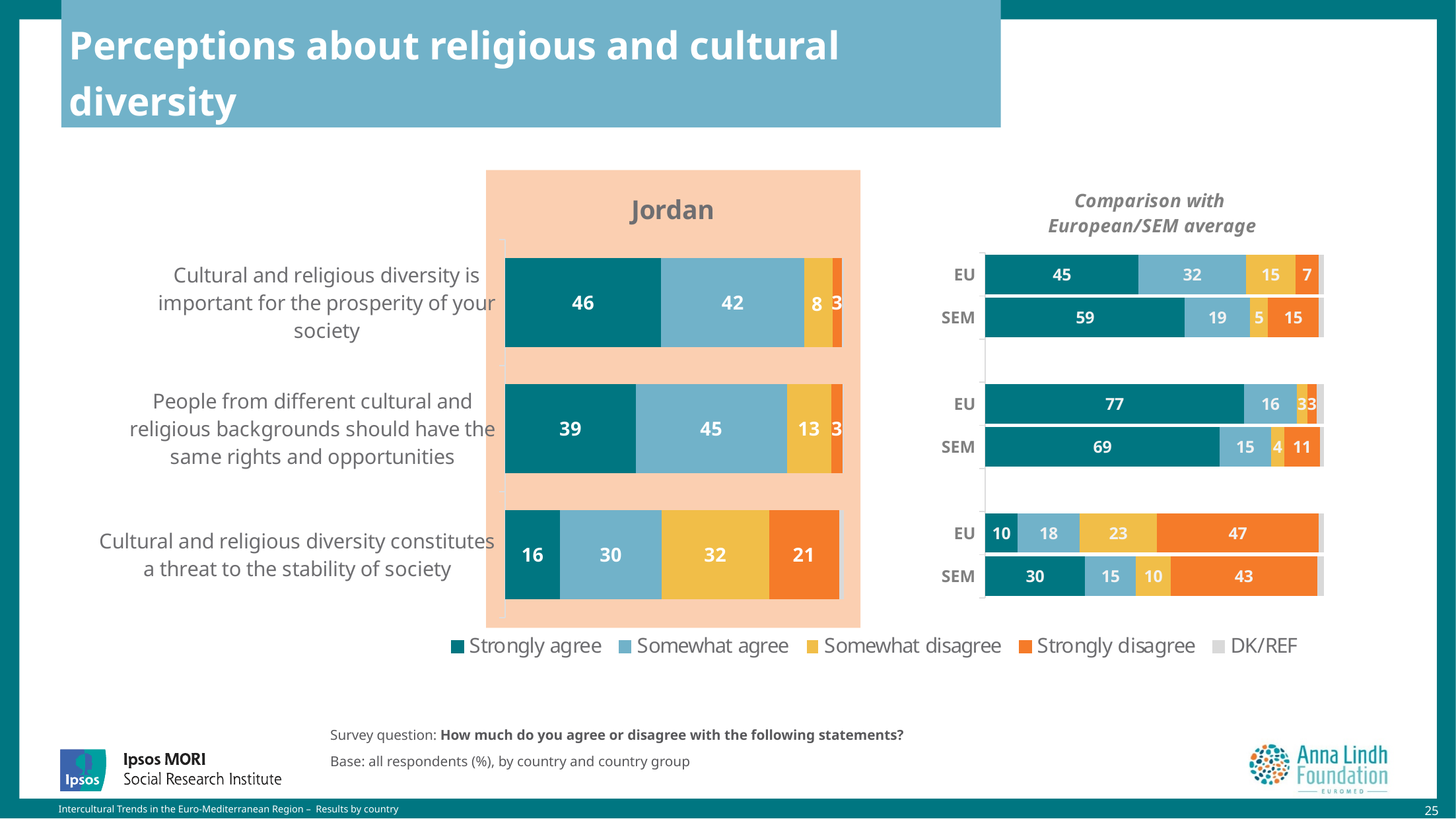
What kind of chart is the Jordan chart? Stacked bar chart In the Comparison with European/SEM average chart, what is the difference between the SEM and EU 'Strongly agree' values for the statement that diversity is important for the prosperity of your society? 14 In the Jordan chart, what percentage strongly agree that cultural and religious diversity is important for the prosperity of your society? 46 In the Comparison with European/SEM average chart, what is the EU 'Strongly agree' value for the statement that people from different backgrounds should have the same rights and opportunities? 77 In the Jordan chart, for the statement that people from different backgrounds should have the same rights and opportunities, how much larger is 'Somewhat agree' than 'Strongly agree'? 6 In the Jordan chart, what percentage strongly disagree that cultural and religious diversity constitutes a threat to the stability of society? 21 How many series does the legend list? 5 What is the title of the chart on the right side of the slide? Comparison with European/SEM average In the Jordan chart, for the statement that diversity constitutes a threat to the stability of society, which is larger: 'Somewhat disagree' or 'Strongly disagree'? Somewhat disagree How many statements are shown in the Jordan chart? 3 In the Jordan chart, which statement has the highest 'Strongly agree' value? Cultural and religious diversity is important for the prosperity of your society In the Comparison with European/SEM average chart, what is the SEM 'Strongly disagree' value for the statement that diversity constitutes a threat to the stability of society? 43